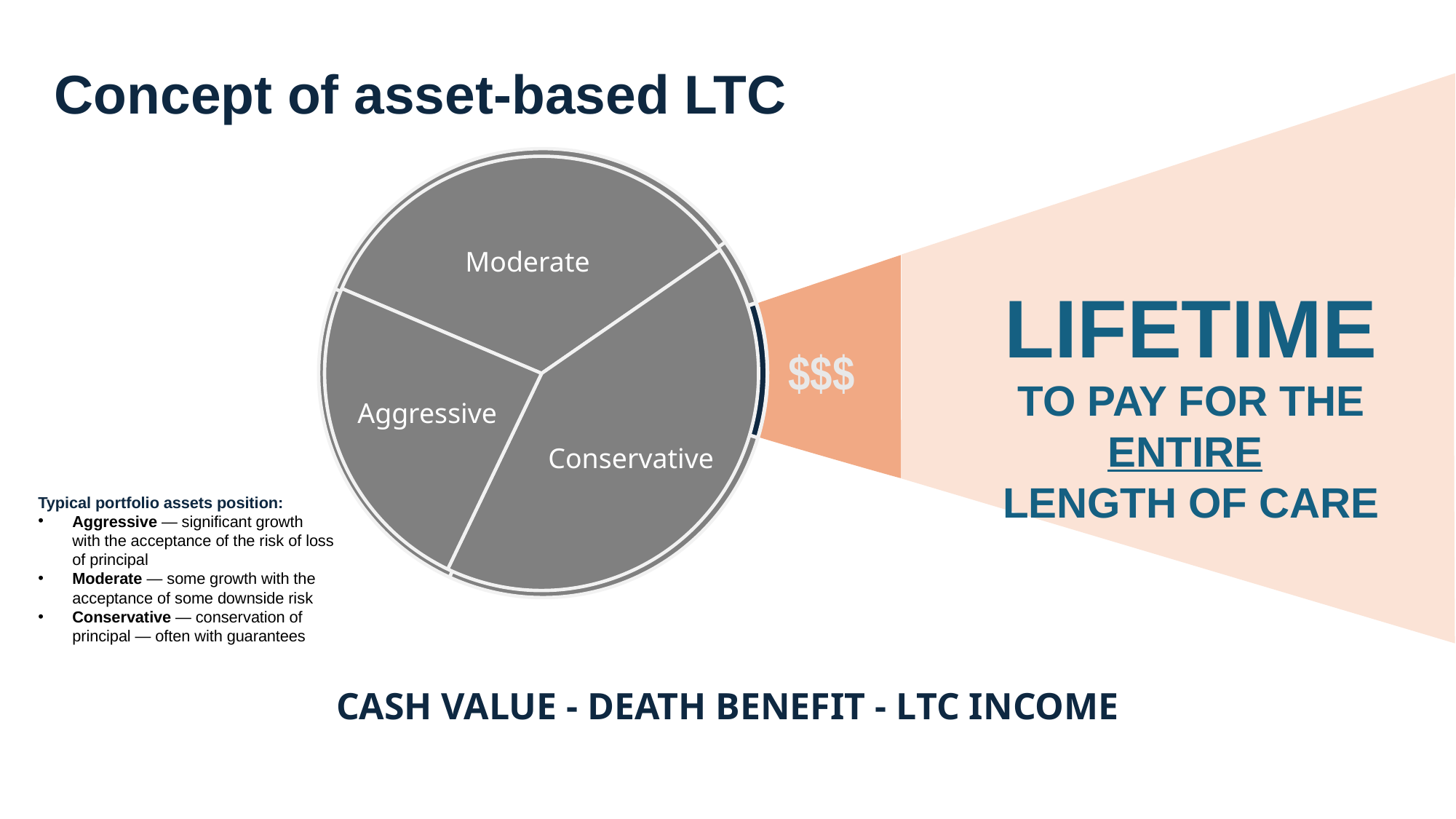
What kind of chart is shown on the slide? pie chart What colour are the labeled slices of the pie chart? grey What are the labels of the three slices in the pie chart? Moderate, Aggressive, Conservative Which labeled slice of the pie chart is the smallest? Aggressive How many labeled slices does the pie chart have? 3 Which slice of the pie chart is larger, Moderate or Aggressive? Moderate Which slice of the pie chart is larger, Conservative or Aggressive? Conservative